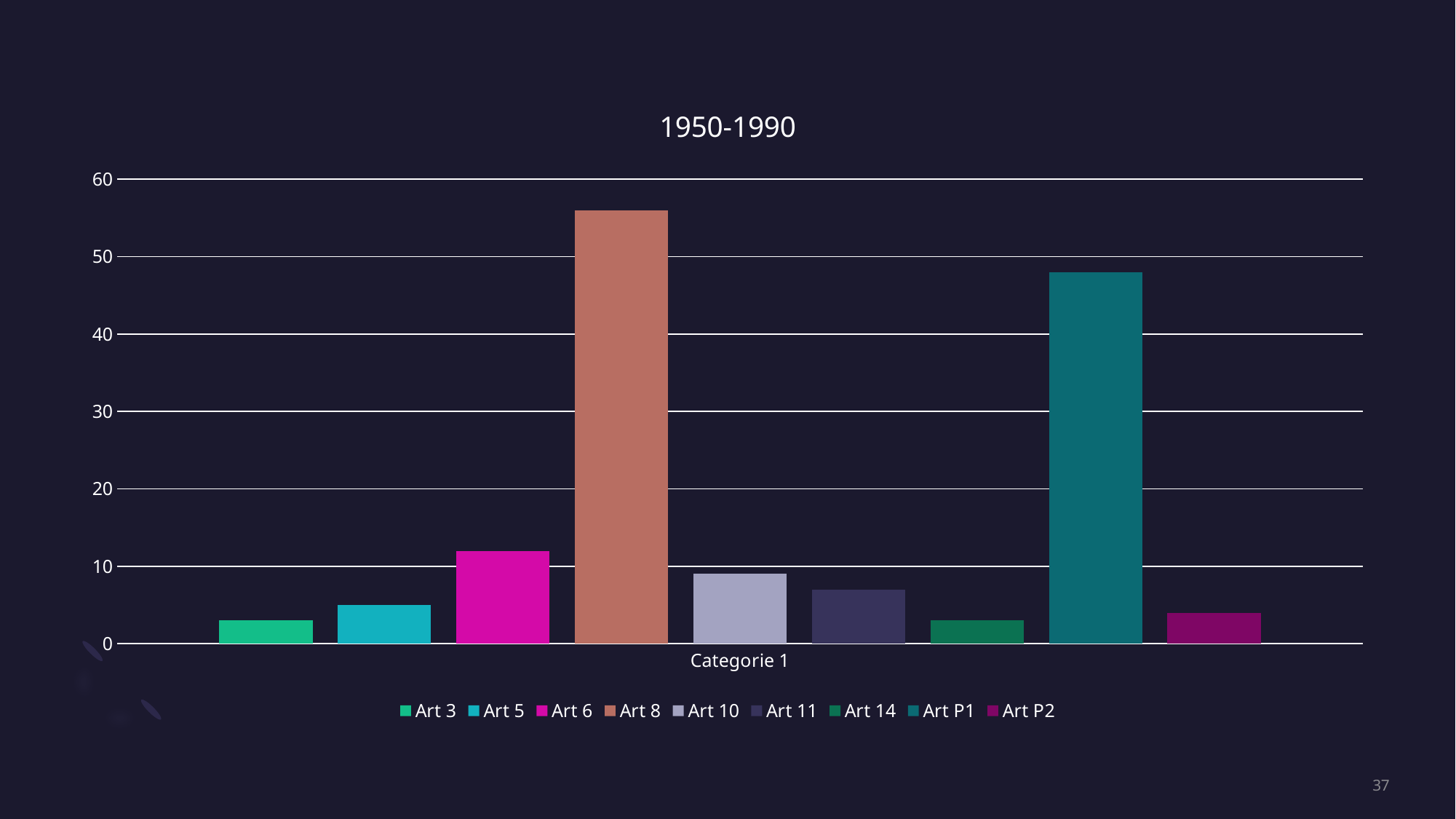
Is the value for Art 8 greater or less than 50? greater Which series has the highest value in the chart? Art 8 What is the title of the chart? 1950-1990 How many categories are shown on the x axis? 1 What type of chart is shown on the slide? bar chart Is the value for Art 11 greater or less than 10? less Which is larger, the value for Art 6 or the value for Art 10? Art 6 What is the label of the category on the x axis? Categorie 1 Is the value for Art P1 greater or less than 50? less Which is larger, the value for Art 8 or the value for Art P1? Art 8 How many series does the legend list? 9